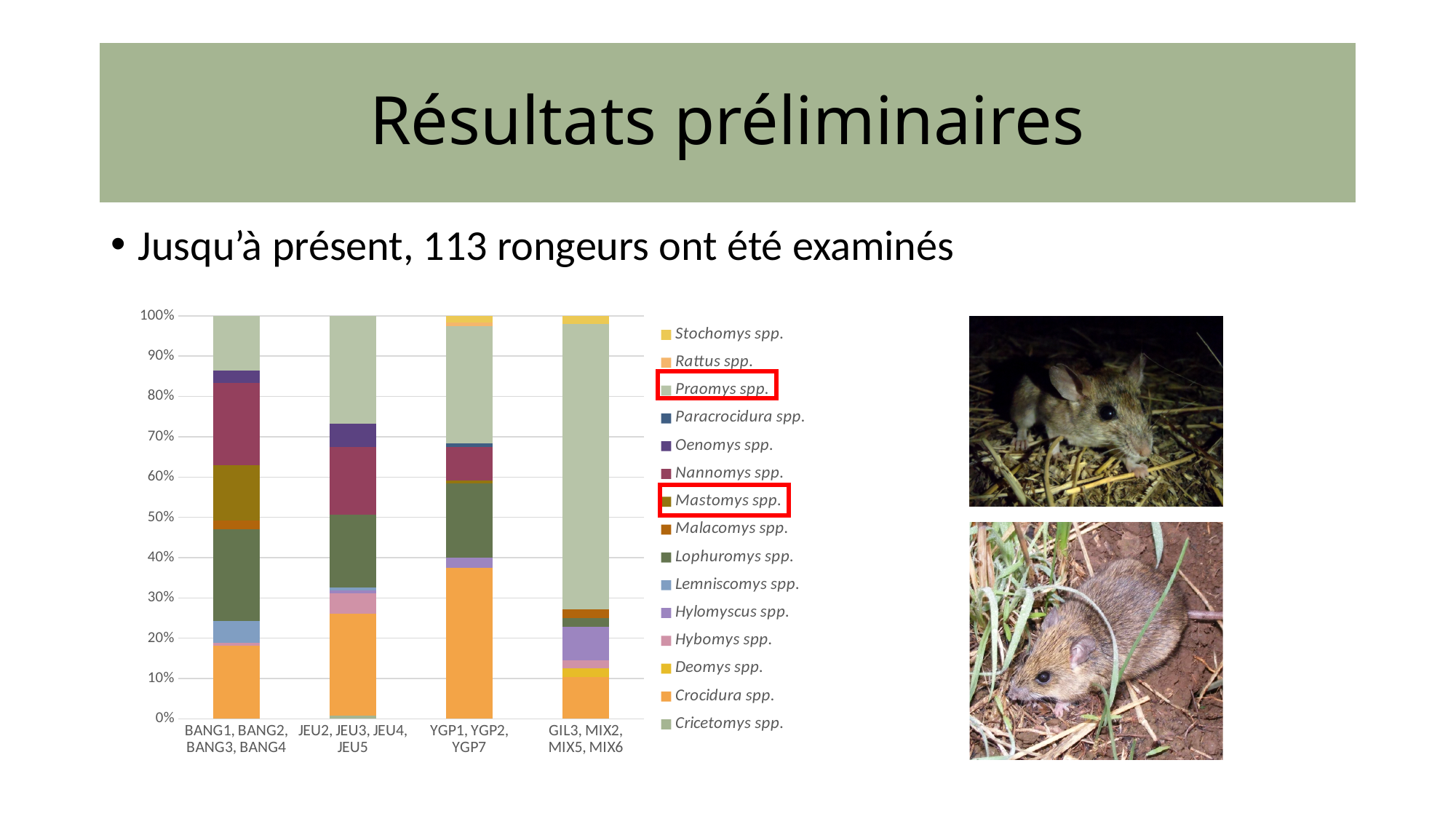
Is the share of Mastomys spp. in the BANG1, BANG2, BANG3, BANG4 group greater or less than 10%? greater How many site groups (categories) are shown on the x axis of the chart? 4 What is the maximum value shown on the y axis of the chart? 100% Which two legend entries are highlighted with red boxes? Praomys spp. and Mastomys spp. Is the share of Praomys spp. in the GIL3, MIX2, MIX5, MIX6 group greater or less than 60%? greater What kind of chart is shown on the slide? Stacked bar chart Which site group has the largest share of Praomys spp.? GIL3, MIX2, MIX5, MIX6 Which site group has the larger share of Crocidura spp.: BANG1, BANG2, BANG3, BANG4 or YGP1, YGP2, YGP7? YGP1, YGP2, YGP7 Is the share of Praomys spp. in the BANG1, BANG2, BANG3, BANG4 group greater or less than 20%? less How many species (series) does the chart legend list? 15